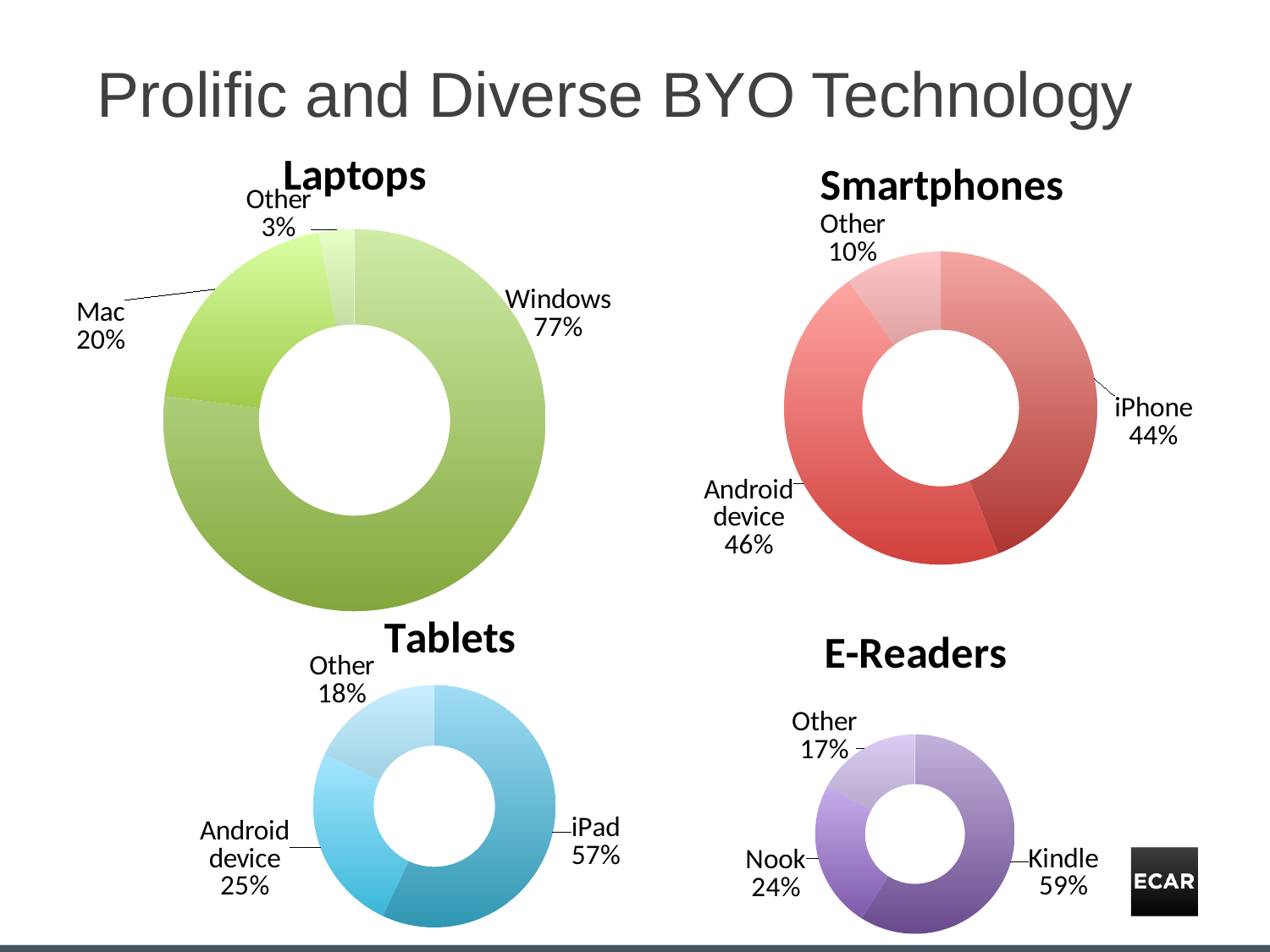
In the Tablets chart, which is larger, the Android device share or the Other share? Android device In the Smartphones chart, what share is Android device? 46% In the E-Readers chart, which category has the largest share? Kindle In the Smartphones chart, what is the difference between the Android device share and the iPhone share? 2% What is the title of the chart in the bottom right of the slide? E-Readers In the Laptops chart, which category has the smallest share? Other In the E-Readers chart, what share is Nook? 24% How many categories does the Laptops chart show? 3 In the Tablets chart, what share is iPad? 57% How many charts are on the slide? 4 In the Laptops chart, what share is Windows? 77% What kind of chart is the Smartphones chart? Doughnut chart